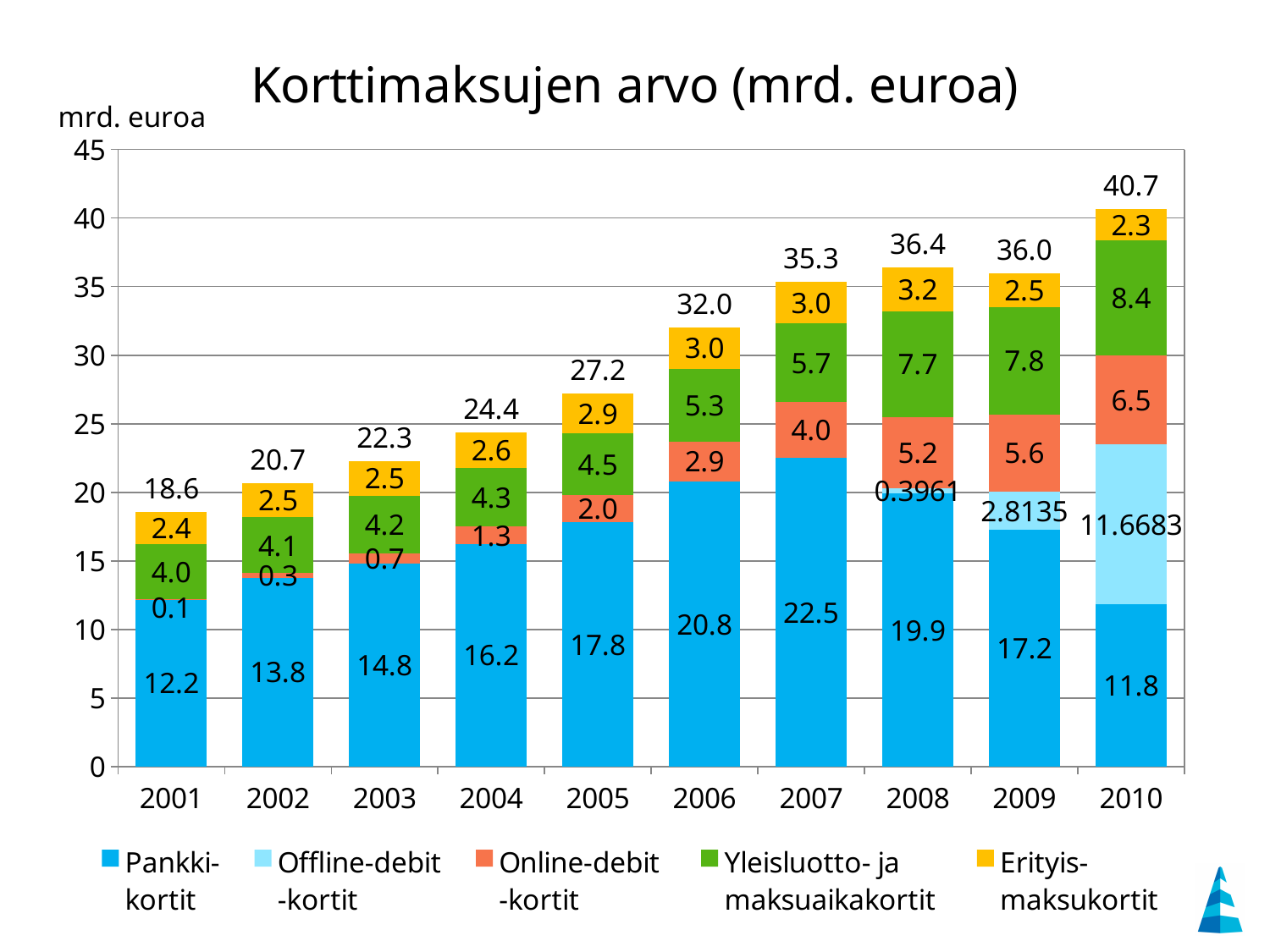
In 2010, which is larger: Yleisluotto- ja maksuaikakortit or Online-debit-kortit? Yleisluotto- ja maksuaikakortit What unit label is shown above the vertical axis? mrd. euroa What is the value for Offline-debit-kortit in 2009? 2.8135 How many series does the legend list? 5 What kind of chart is shown on the slide? stacked bar chart How many years are shown on the x axis? 10 Which year has the highest total value? 2010 Do the total values generally rise or fall from 2001 to 2010? rise Which year has the lowest total value? 2001 What is the difference between the total for 2010 and the total for 2009? 4.7 What is the value for Pankkikortit in 2007? 22.5 What is the total value of the stacked bar for 2010? 40.7